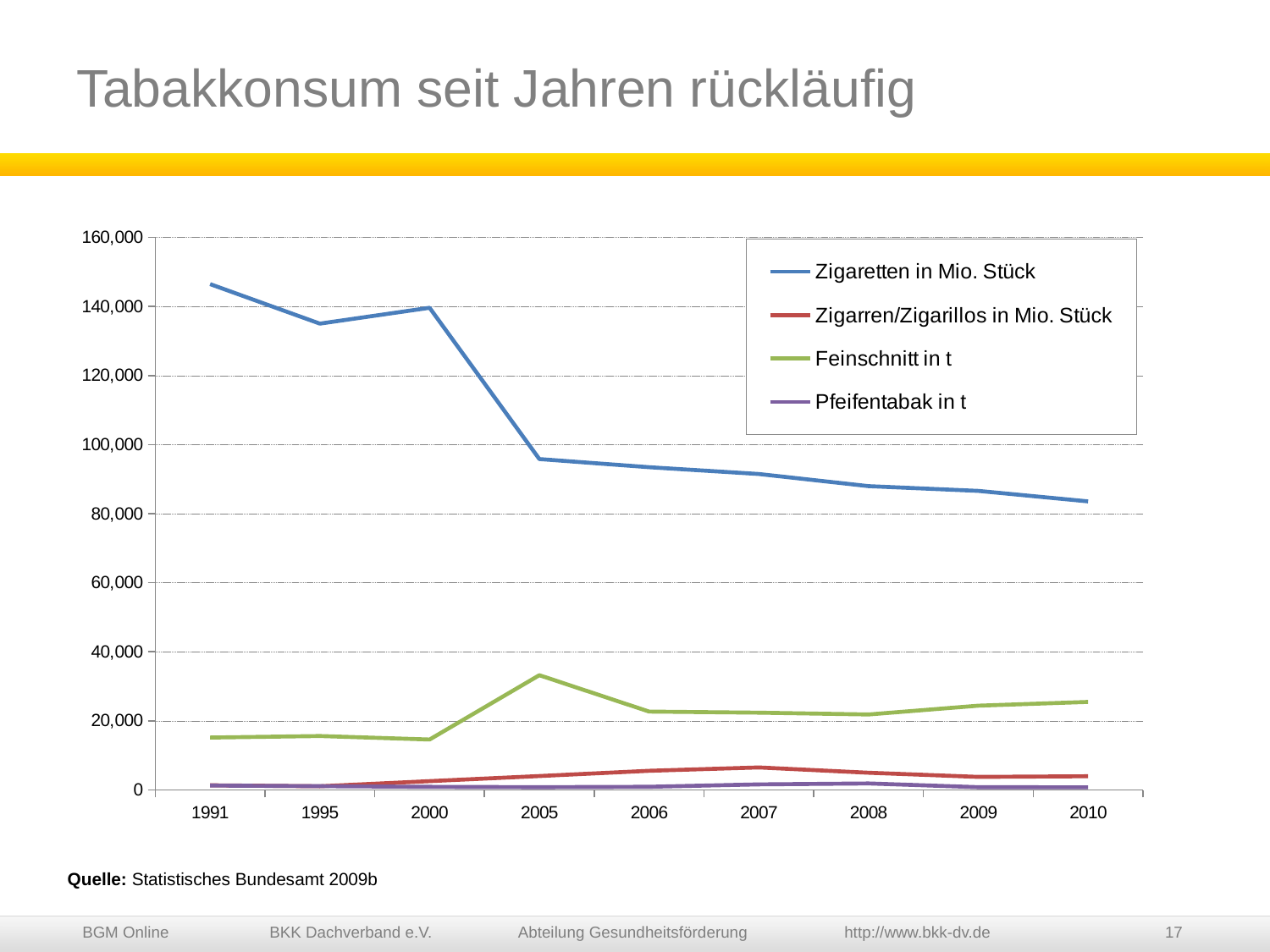
Is the value for Feinschnitt in t in 2005 greater or less than 20,000? greater Does the Zigaretten in Mio. Stück line rise or fall overall from 1991 to 2010? fall What is the title of the slide above the chart? Tabakkonsum seit Jahren rückläufig Is the value for Zigaretten in Mio. Stück in 1991 greater or less than 140,000? greater Is the value for Zigaretten in Mio. Stück in 2005 greater or less than 100,000? less How many years are shown on the x axis? 9 Which series has the lowest values across the whole chart? Pfeifentabak in t Is the value for Zigaretten in Mio. Stück larger in 2000 or in 2005? 2000 In which year is the value for Zigaretten in Mio. Stück highest? 1991 What kind of chart is shown on the slide? line chart Which series is drawn with the blue line? Zigaretten in Mio. Stück How many series does the legend list? 4